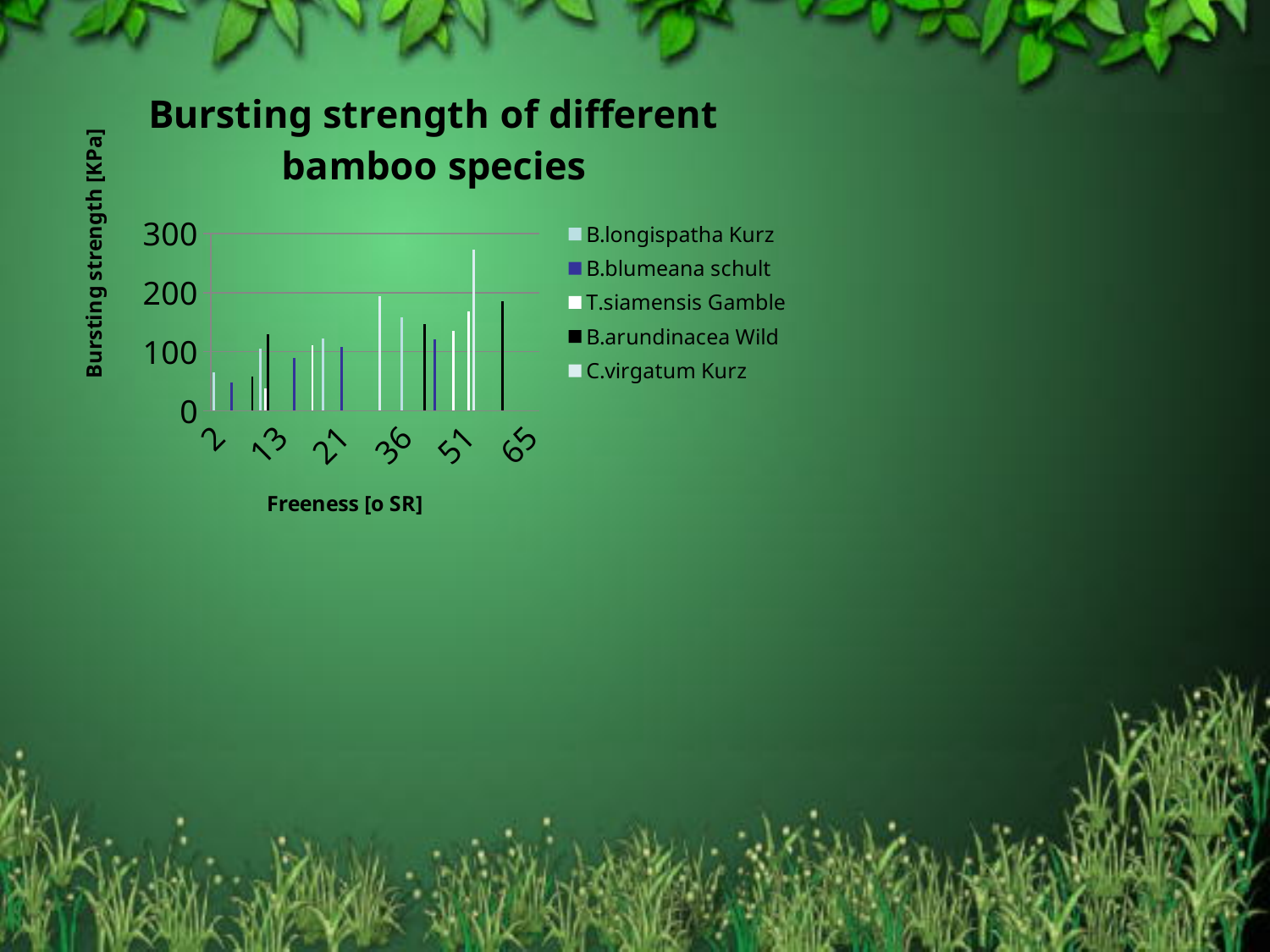
What is the title of the chart? Bursting strength of different bamboo species What kind of chart is shown on the slide? bar chart Is any bar in the chart greater than 300? No What is the label of the y axis? Bursting strength [KPa] How many series does the chart's legend list? 5 Is the tallest bar in the chart greater or less than 200? greater